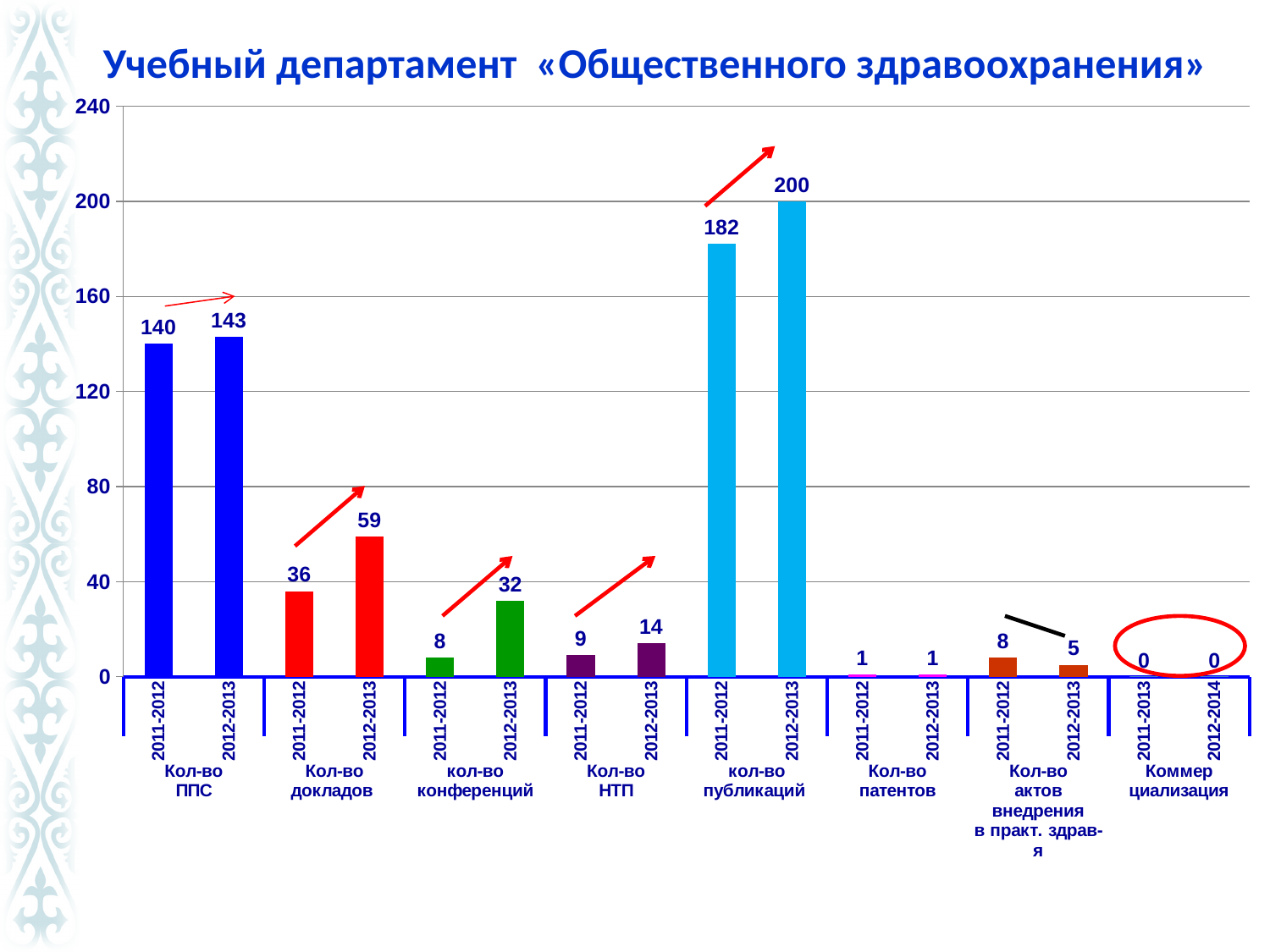
What is the value for Кол-во ППС in 2012-2013? 143 What kind of chart is shown on the slide? bar chart How many categories are shown on the x axis of the chart? 8 What is the difference between the 2012-2013 and 2011-2012 values for Кол-во докладов? 23 Which category has the lowest value in 2011-2012? Кол-во патентов Which category has the highest value in 2012-2013? кол-во публикаций What is the value for кол-во публикаций in 2011-2012? 182 Is the value for Кол-во ППС in 2011-2012 greater or less than 120? greater What is the value for кол-во конференций in 2011-2012? 8 What is the difference between the 2012-2013 and 2011-2012 values for кол-во публикаций? 18 What is the value for Кол-во докладов in 2012-2013? 59 Which is larger for Кол-во актов внедрения в практ. здрав-я: the 2011-2012 value or the 2012-2013 value? 2011-2012